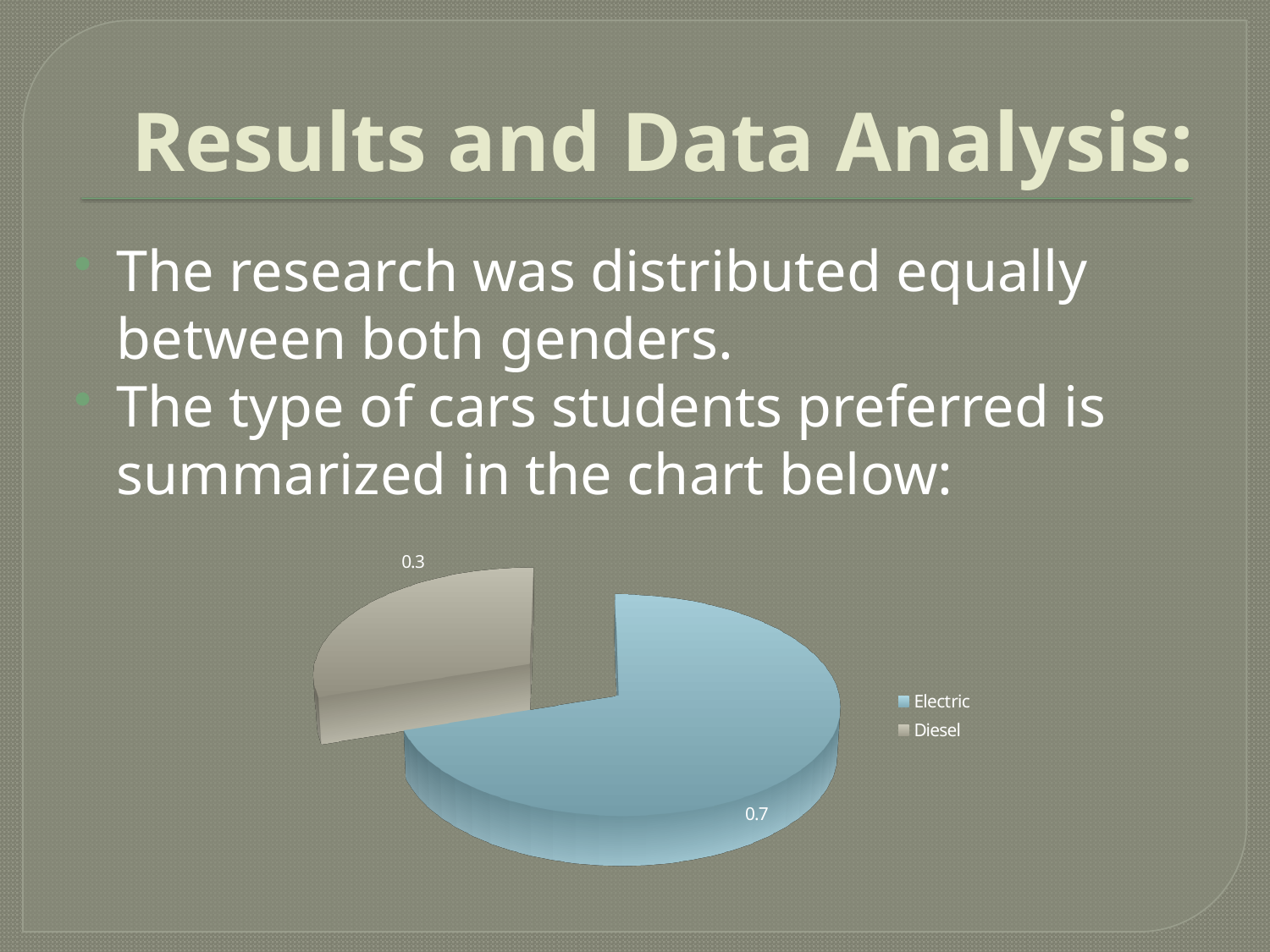
What kind of chart is shown on the slide? pie chart What is the value for Diesel in the pie chart? 0.3 How many categories does the pie chart show? 2 Which category has the smallest slice in the pie chart? Diesel Which legend entry is listed first? Electric Which is larger, the value for Electric or the value for Diesel? Electric What colour is the Electric slice in the pie chart? blue What is the value for Electric in the pie chart? 0.7 What is the difference between the Electric and Diesel values? 0.4 How many entries does the legend list? 2 Which category has the largest slice in the pie chart? Electric